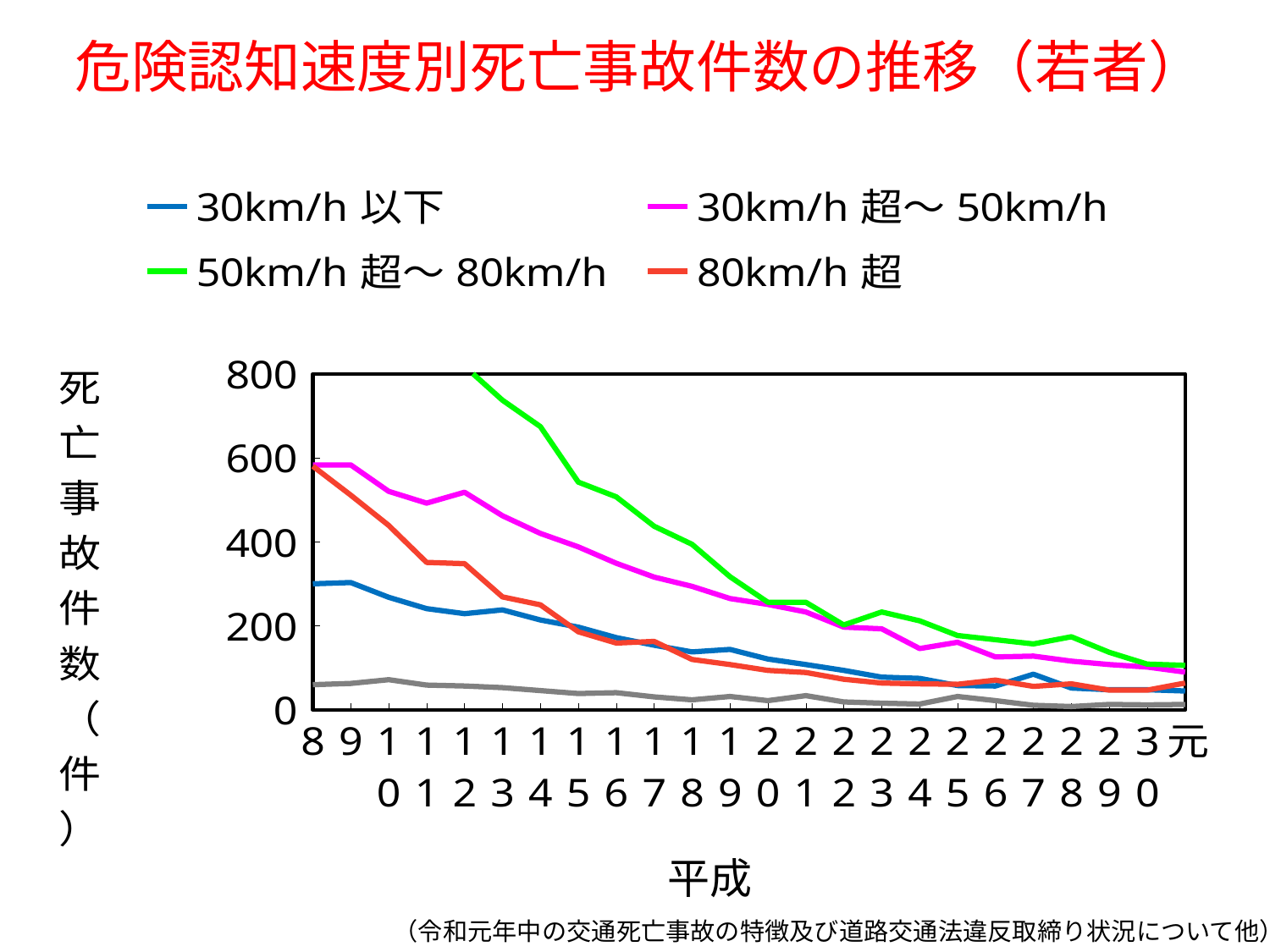
Which legend series has the highest value at 平成16? 50km/h 超〜 80km/h Is the value for 50km/h 超〜 80km/h at 平成14 greater or less than 600? greater Is the value for 50km/h 超〜 80km/h at 平成30 greater or less than 200? less Does the 50km/h 超〜 80km/h series rise or fall along the x axis overall? fall Is the value for 30km/h 以下 at 平成8 greater or less than 400? less How many points are on the x axis (from 平成8 to 元)? 24 At 平成20, which is larger: 50km/h 超〜 80km/h or 30km/h 以下? 50km/h 超〜 80km/h What is the title of the chart? 危険認知速度別死亡事故件数の推移（若者） How many series does the legend list? 4 At 平成8, which is larger: 30km/h 超〜 50km/h or 30km/h 以下? 30km/h 超〜 50km/h What kind of chart is shown on the slide? line chart